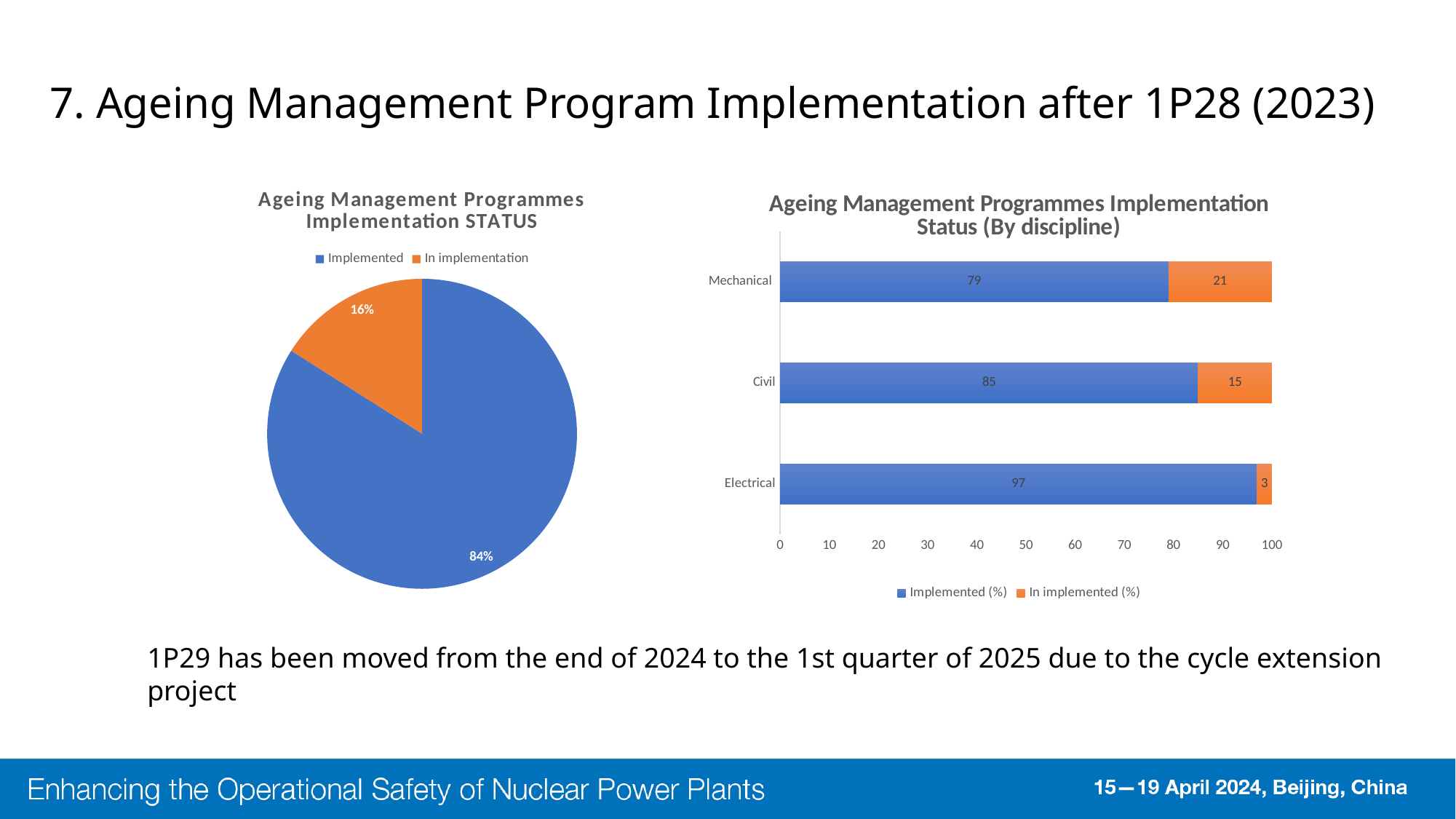
In the bar chart 'Ageing Management Programmes Implementation Status (By discipline)', what is the Implemented (%) value for Mechanical? 79 In the bar chart 'Ageing Management Programmes Implementation Status (By discipline)', which discipline has the highest Implemented (%) value? Electrical In the bar chart 'Ageing Management Programmes Implementation Status (By discipline)', what is the total of the stacked bar for Civil? 100 In the bar chart 'Ageing Management Programmes Implementation Status (By discipline)', which discipline has the lowest In implemented (%) value? Electrical In the bar chart 'Ageing Management Programmes Implementation Status (By discipline)', how many series does the legend list? 2 In the bar chart 'Ageing Management Programmes Implementation Status (By discipline)', what is the In implemented (%) value for Civil? 15 What kind of chart is the chart on the left of the slide? Pie chart In the bar chart 'Ageing Management Programmes Implementation Status (By discipline)', what is the difference between the Implemented (%) values for Electrical and Mechanical? 18 In the pie chart on the left, how many slices are there? 2 In the pie chart 'Ageing Management Programmes Implementation STATUS', what share is labelled In implementation? 16% In the pie chart 'Ageing Management Programmes Implementation STATUS', what share is labelled Implemented? 84% What kind of chart is the chart on the right of the slide? Bar chart